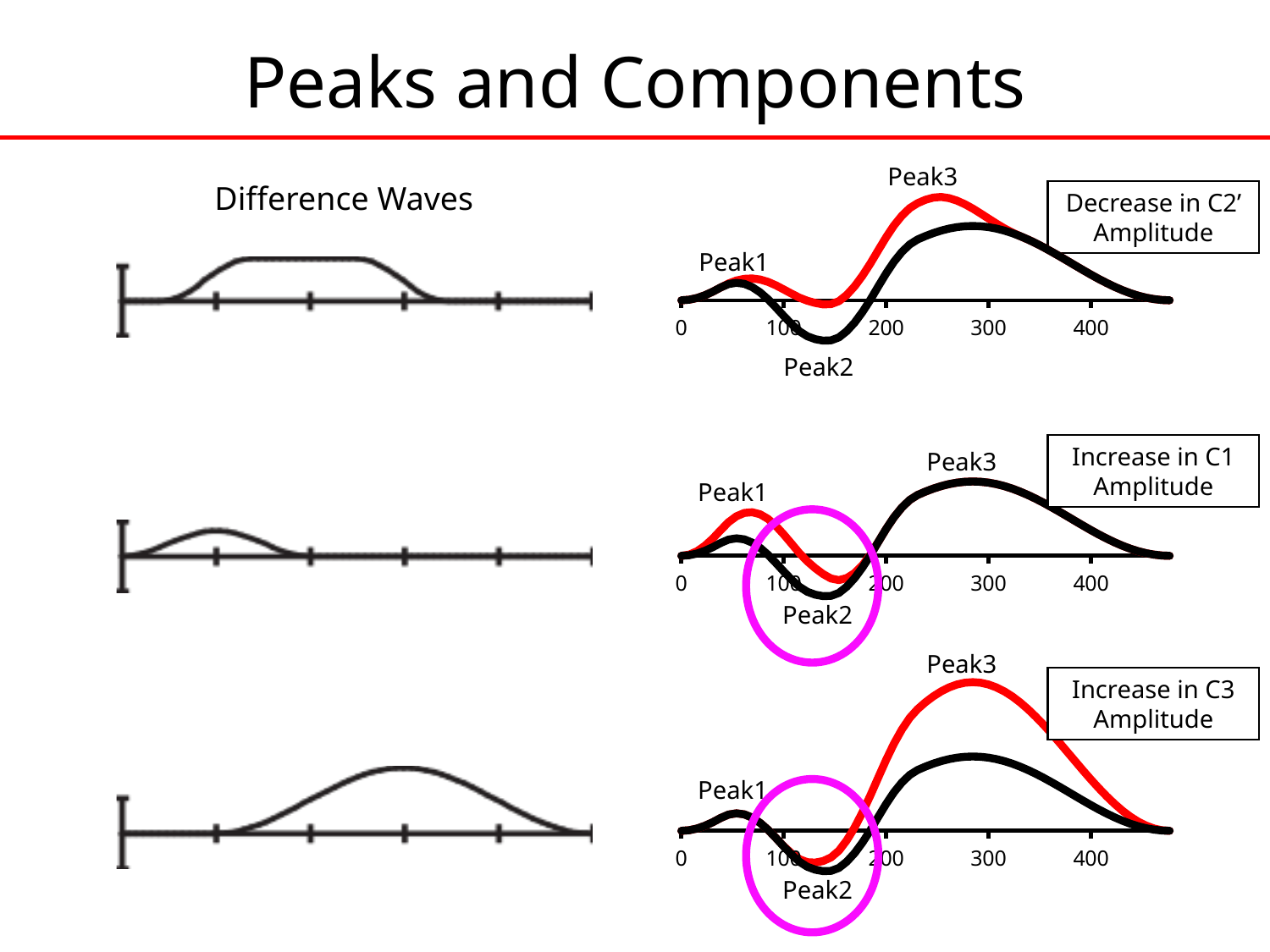
How many lines are plotted in the bottom right chart? 2 Which peak is circled in magenta in the middle and bottom right charts? Peak2 In the middle right chart, which line reaches a higher Peak1, the red line or the black line? red In the bottom right chart, is the x-axis position of Peak3 greater or less than 400? less In the middle right chart, is the x-axis position of Peak2 greater or less than 100? greater What text is in the box next to the top right chart? Decrease in C2' Amplitude In the bottom right chart, which line reaches a higher Peak3, the red line or the black line? red What kind of chart is the top right chart on the slide? line chart In the top right chart, is the x-axis position of Peak3 greater or less than 200? greater In the top right chart, which line has a higher Peak3, the red line or the black line? red How many labeled peaks are marked on the top right chart? 3